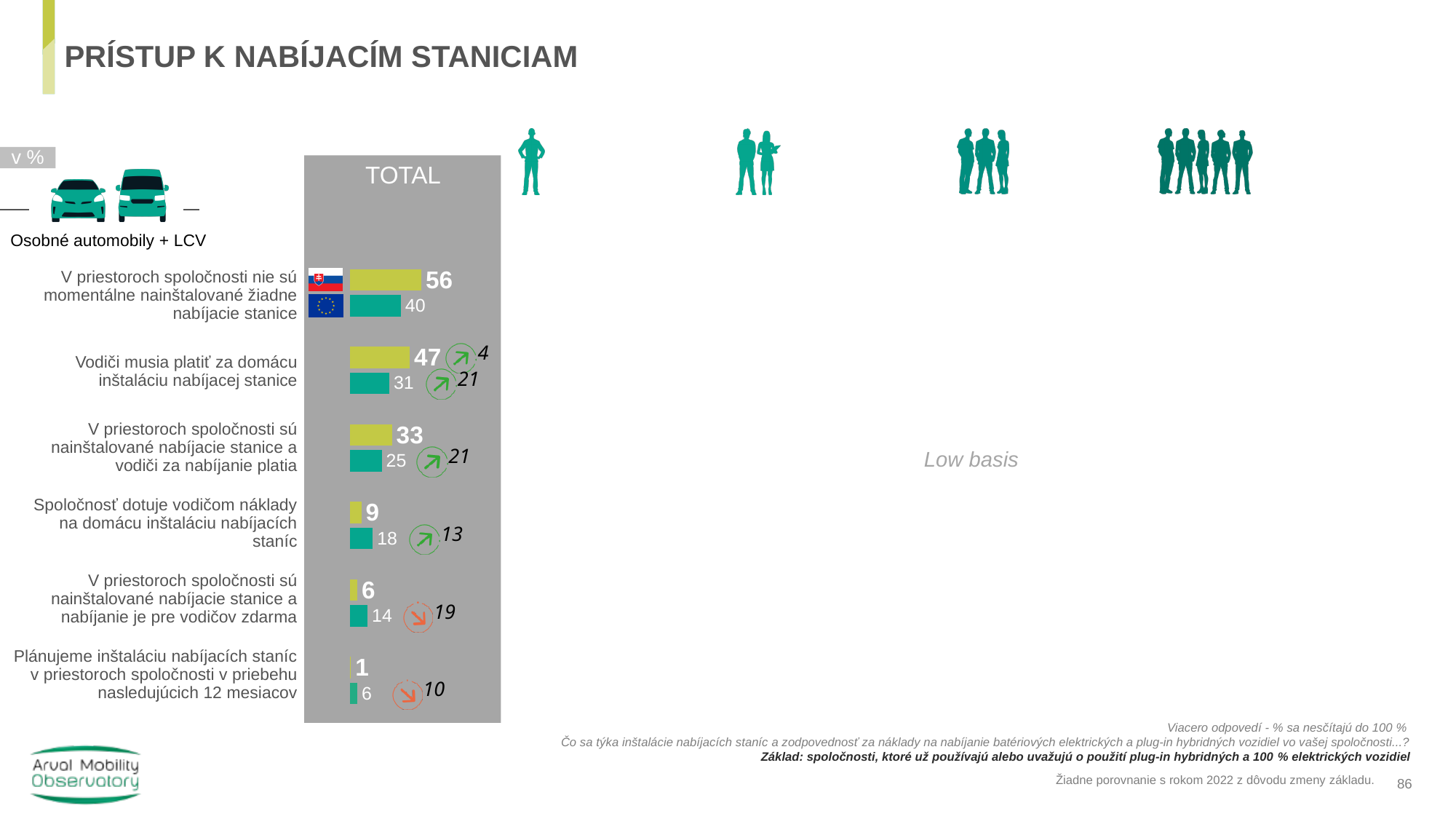
Which category has the highest Slovakia value? V priestoroch spoločnosti nie sú momentálne nainštalované žiadne nabíjacie stanice For "V priestoroch spoločnosti sú nainštalované nabíjacie stanice a vodiči za nabíjanie platia", which is larger: the Slovakia value or the EU value? Slovakia What is the EU value for "Vodiči musia platiť za domácu inštaláciu nabíjacej stanice"? 31 What is the Slovakia value for "Spoločnosť dotuje vodičom náklady na domácu inštaláciu nabíjacích staníc"? 9 How many data series does the chart show? 2 What is the Slovakia value for "V priestoroch spoločnosti nie sú momentálne nainštalované žiadne nabíjacie stanice"? 56 What is the difference between the Slovakia and EU values for "V priestoroch spoločnosti nie sú momentálne nainštalované žiadne nabíjacie stanice"? 16 For "V priestoroch spoločnosti sú nainštalované nabíjacie stanice a nabíjanie je pre vodičov zdarma", which is larger: the Slovakia value or the EU value? EU Which category has the lowest EU value? Plánujeme inštaláciu nabíjacích staníc v priestoroch spoločnosti v priebehu nasledujúcich 12 mesiacov How many categories are shown in the chart? 6 What kind of chart is shown on the slide? Bar chart What is the EU value for "Plánujeme inštaláciu nabíjacích staníc v priestoroch spoločnosti v priebehu nasledujúcich 12 mesiacov"? 6